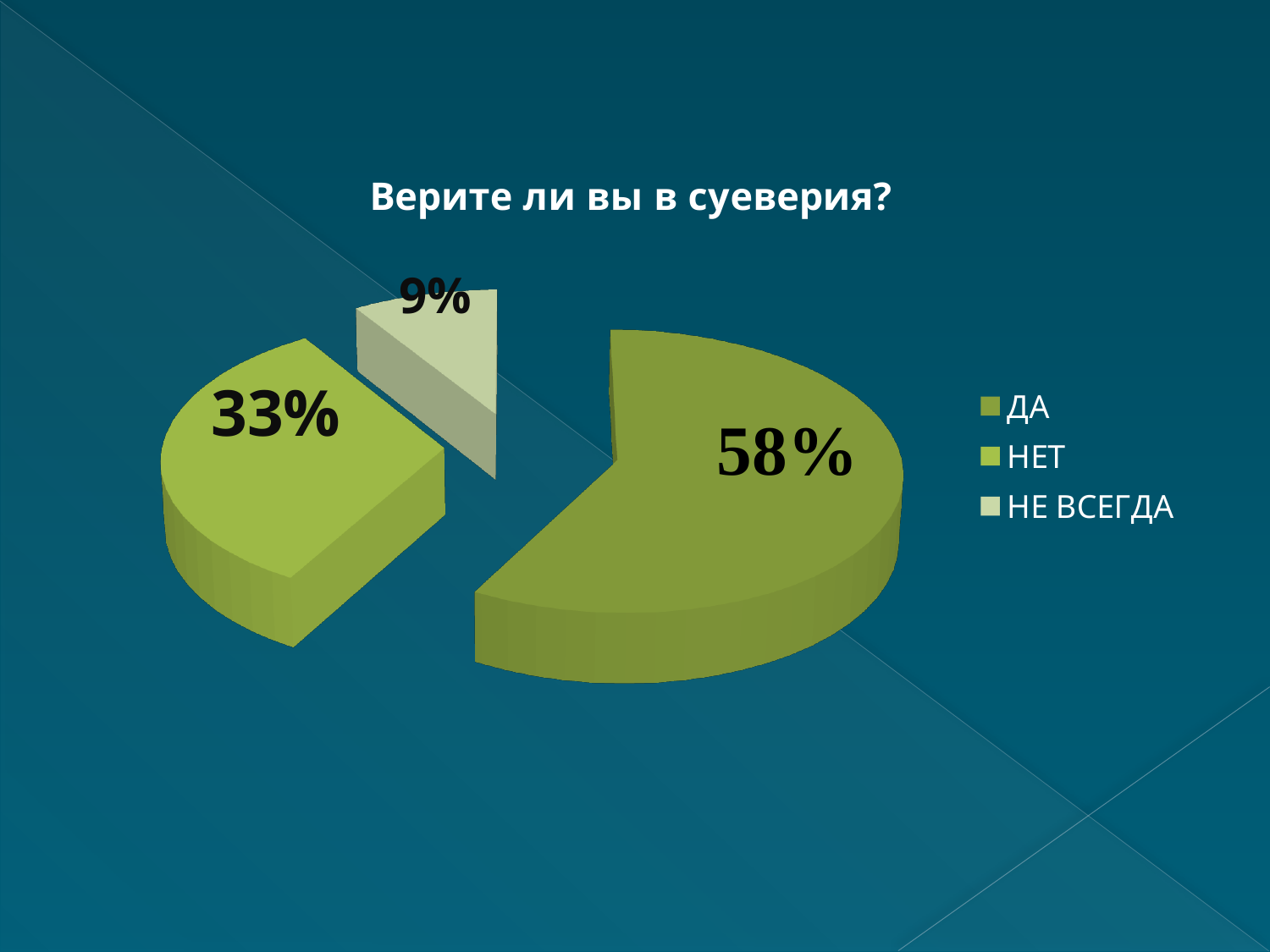
What share of the pie does НЕ ВСЕГДА have? 9% Which category has the smallest slice? НЕ ВСЕГДА What kind of chart is shown on the slide? pie chart What is the title of the chart? Верите ли вы в суеверия? What share of the pie does ДА have? 58% How many categories does the pie chart have? 3 What is the difference between the ДА and НЕТ shares? 25% What is the difference between the НЕТ and НЕ ВСЕГДА shares? 24% Which category has the largest slice? ДА How many entries does the legend list? 3 Which is larger, the share for НЕТ or the share for НЕ ВСЕГДА? НЕТ What share of the pie does НЕТ have? 33%